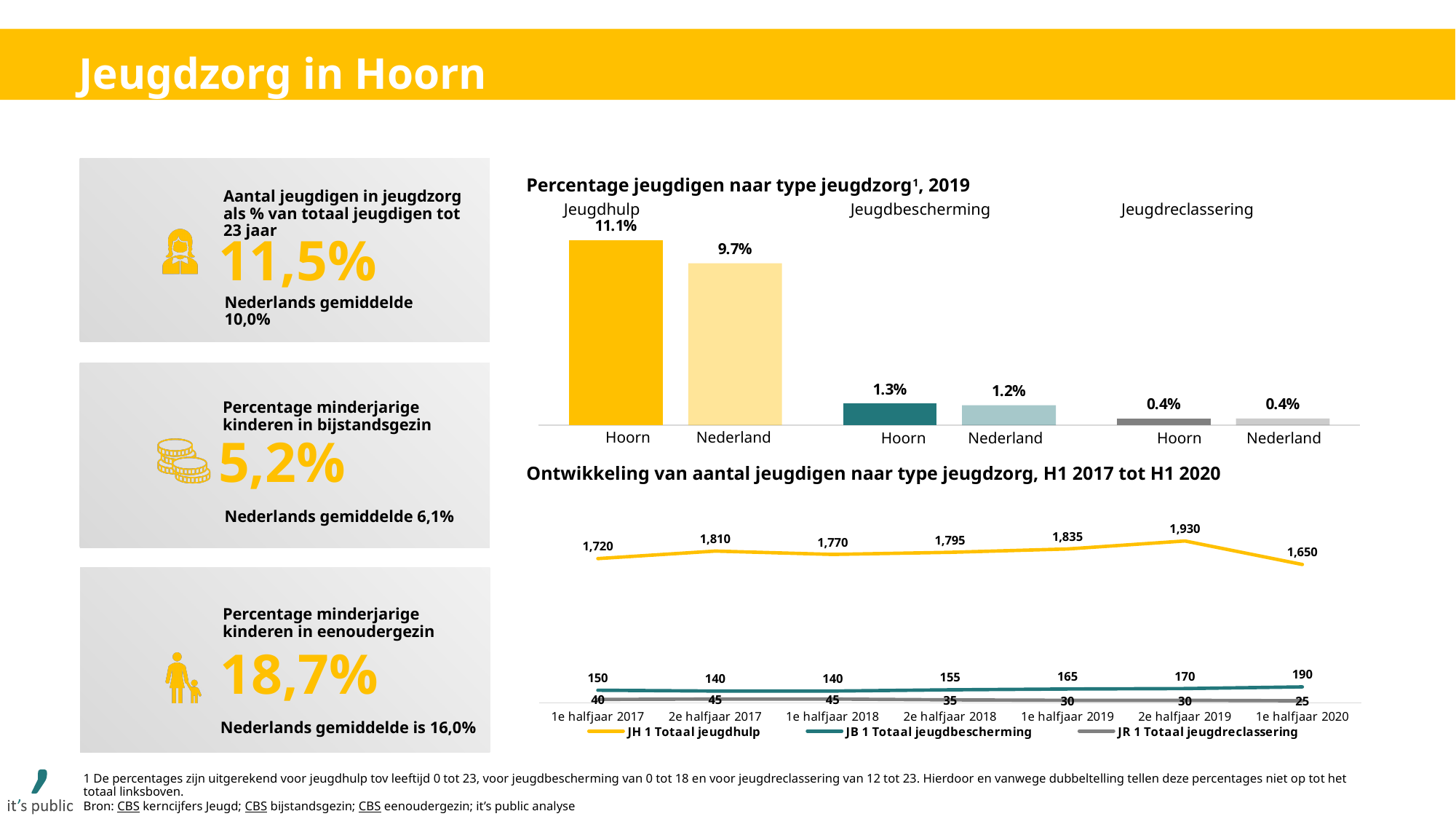
In the chart 'Ontwikkeling van aantal jeugdigen naar type jeugdzorg, H1 2017 tot H1 2020', what is the value of JB 1 Totaal jeugdbescherming in 1e halfjaar 2020? 190 In the chart 'Percentage jeugdigen naar type jeugdzorg, 2019', what is the difference between the Jeugdhulp percentages for Hoorn and Nederland? 1.4% What kind of chart is 'Percentage jeugdigen naar type jeugdzorg, 2019'? Bar chart In the chart 'Percentage jeugdigen naar type jeugdzorg, 2019', what is the Jeugdreclassering percentage for Hoorn? 0.4% In the chart 'Ontwikkeling van aantal jeugdigen naar type jeugdzorg, H1 2017 tot H1 2020', how many time periods are shown on the x axis? 7 In the chart 'Percentage jeugdigen naar type jeugdzorg, 2019', which bar is the highest? Jeugdhulp Hoorn In the chart 'Percentage jeugdigen naar type jeugdzorg, 2019', what is the Jeugdhulp percentage for Hoorn? 11.1% In the chart 'Ontwikkeling van aantal jeugdigen naar type jeugdzorg, H1 2017 tot H1 2020', what is the difference between JR 1 Totaal jeugdreclassering in 1e halfjaar 2017 and 1e halfjaar 2020? 15 In the chart 'Percentage jeugdigen naar type jeugdzorg, 2019', what is the Jeugdbescherming percentage for Nederland? 1.2% In the chart 'Ontwikkeling van aantal jeugdigen naar type jeugdzorg, H1 2017 tot H1 2020', in which period is JH 1 Totaal jeugdhulp lowest? 1e halfjaar 2020 In the chart 'Ontwikkeling van aantal jeugdigen naar type jeugdzorg, H1 2017 tot H1 2020', how many series does the legend list? 3 In the chart 'Ontwikkeling van aantal jeugdigen naar type jeugdzorg, H1 2017 tot H1 2020', what is the value of JH 1 Totaal jeugdhulp in 2e halfjaar 2019? 1,930